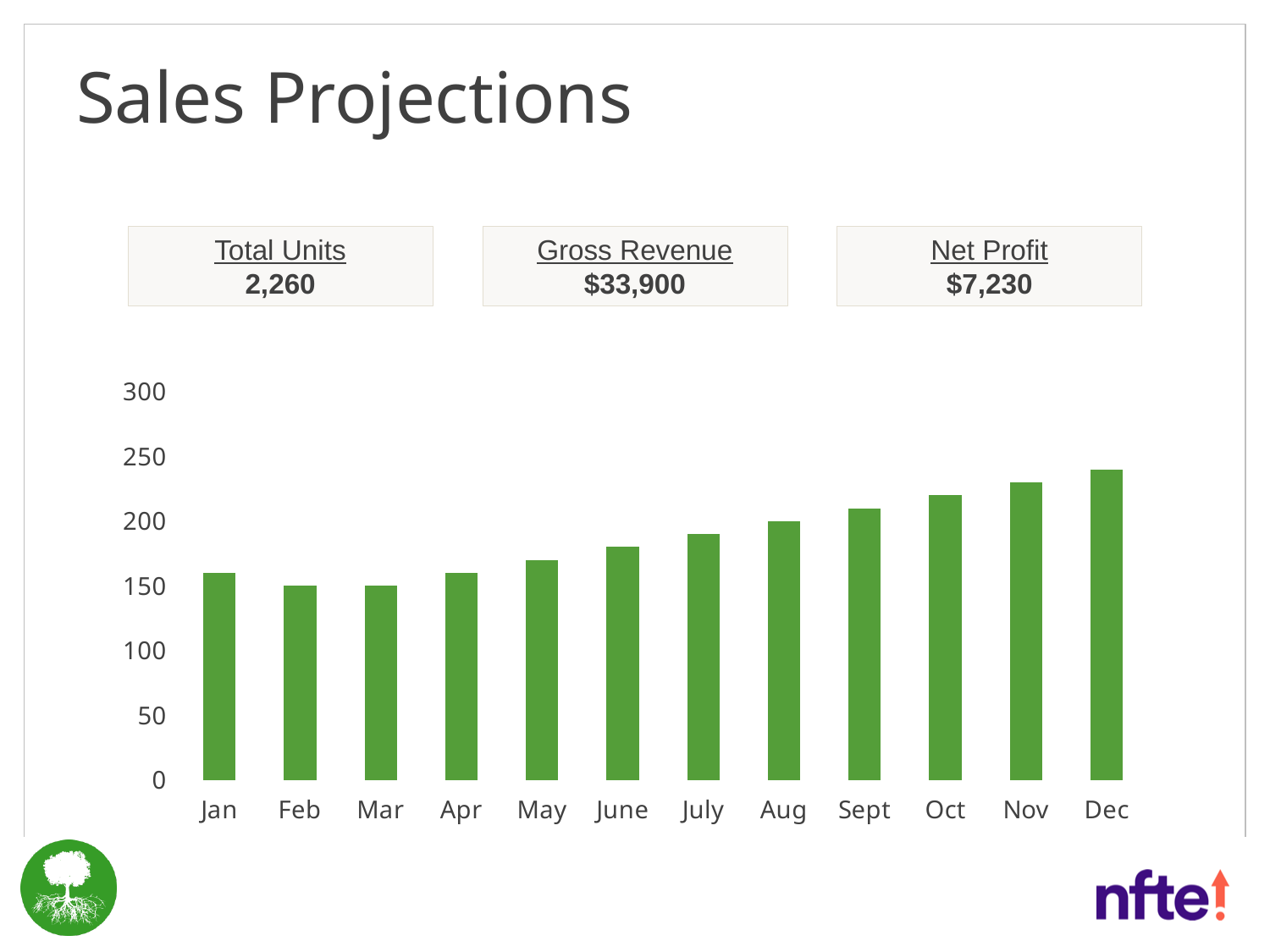
How many months are shown on the x axis of the chart? 12 Which is larger, the value for Apr or the value for Oct? Oct Is the value for Feb greater or less than 200? less Which month has the highest bar in the chart? Dec Which is larger, the value for Dec or the value for Jan? Dec Is the value for Jan greater or less than 100? greater What colour are the bars in the chart? green What kind of chart is shown on the slide? bar chart Do the bar values generally rise or fall from Mar to Dec? rise Is the value for May greater or less than 200? less